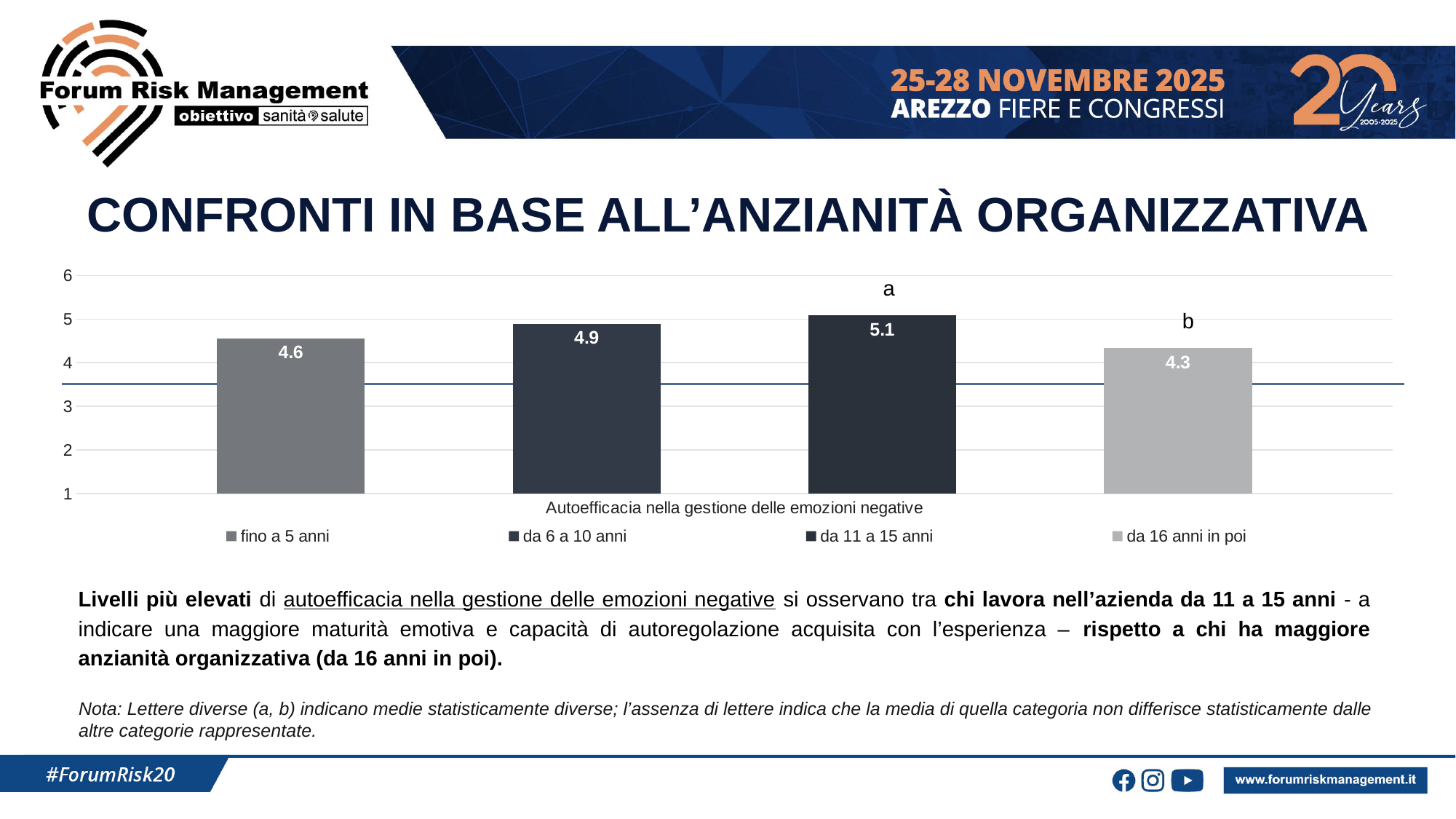
What is the difference between the values for "da 11 a 15 anni" and "da 16 anni in poi"? 0.8 What is the value for "da 6 a 10 anni" in the chart? 4.9 What is the value for "fino a 5 anni" in the chart? 4.6 Which is larger: the value for "da 6 a 10 anni" or the value for "fino a 5 anni"? da 6 a 10 anni What kind of chart is shown on the slide? Bar chart Is the value for "da 11 a 15 anni" greater or less than 5? greater Which group has the highest value in the chart? da 11 a 15 anni How many series does the legend list? 4 What is the value for "da 16 anni in poi" in the chart? 4.3 What is the value for "da 11 a 15 anni" in the chart? 5.1 Which group has the lowest value in the chart? da 16 anni in poi What is the category label shown below the bars on the x axis? Autoefficacia nella gestione delle emozioni negative